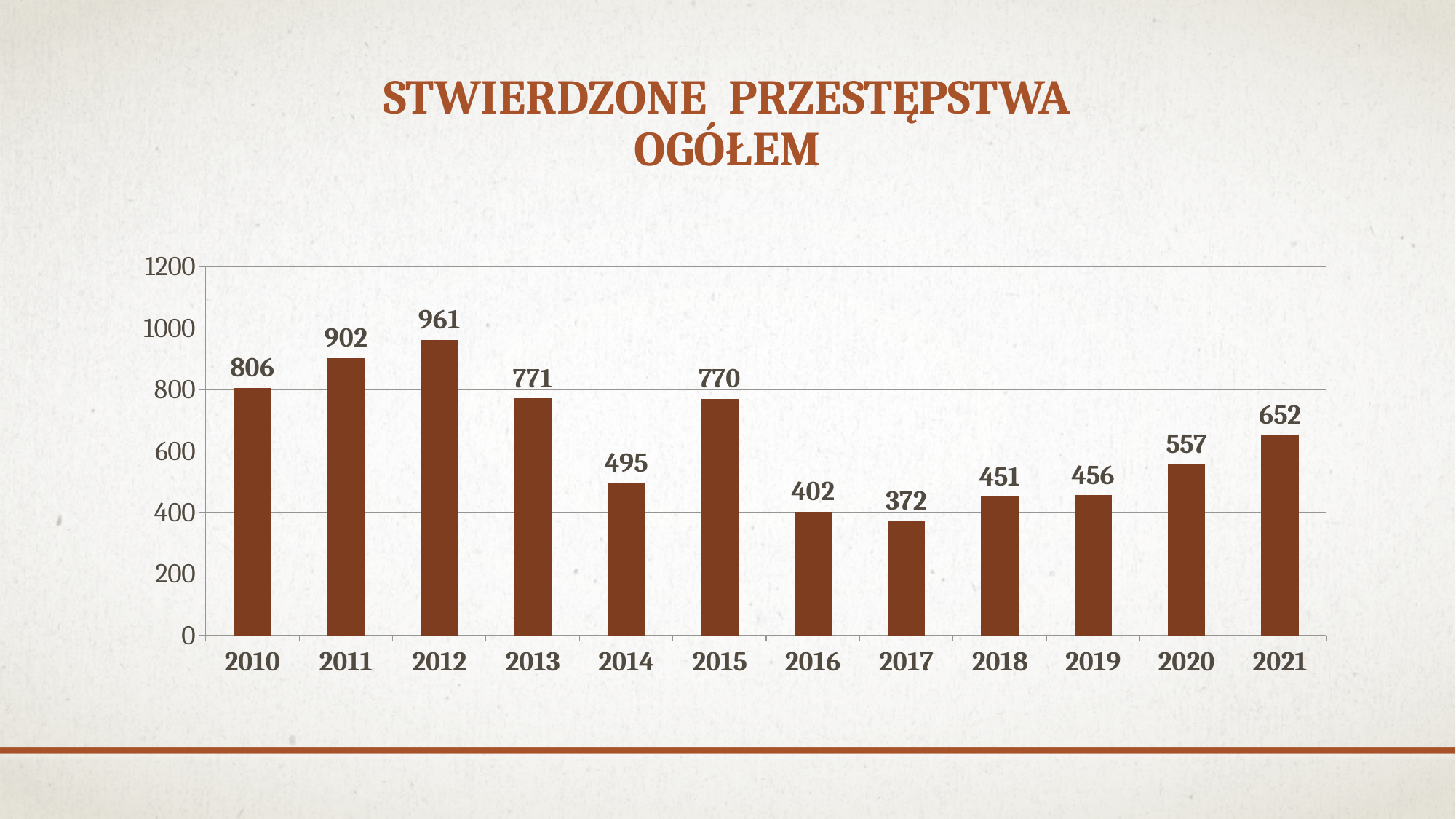
Is the value for 2014 greater or less than 600? less How many years are shown on the x axis? 12 What is the value for 2021? 652 Which is larger, the value for 2011 or the value for 2015? 2011 Which year has the lowest value? 2017 Which year has the highest value? 2012 What is the value for 2017? 372 What is the difference between the values for 2020 and 2021? 95 What is the difference between the values for 2012 and 2017? 589 What is the value for 2012? 961 What is the title of the chart? STWIERDZONE PRZESTĘPSTWA OGÓŁEM What kind of chart is shown on the slide? bar chart